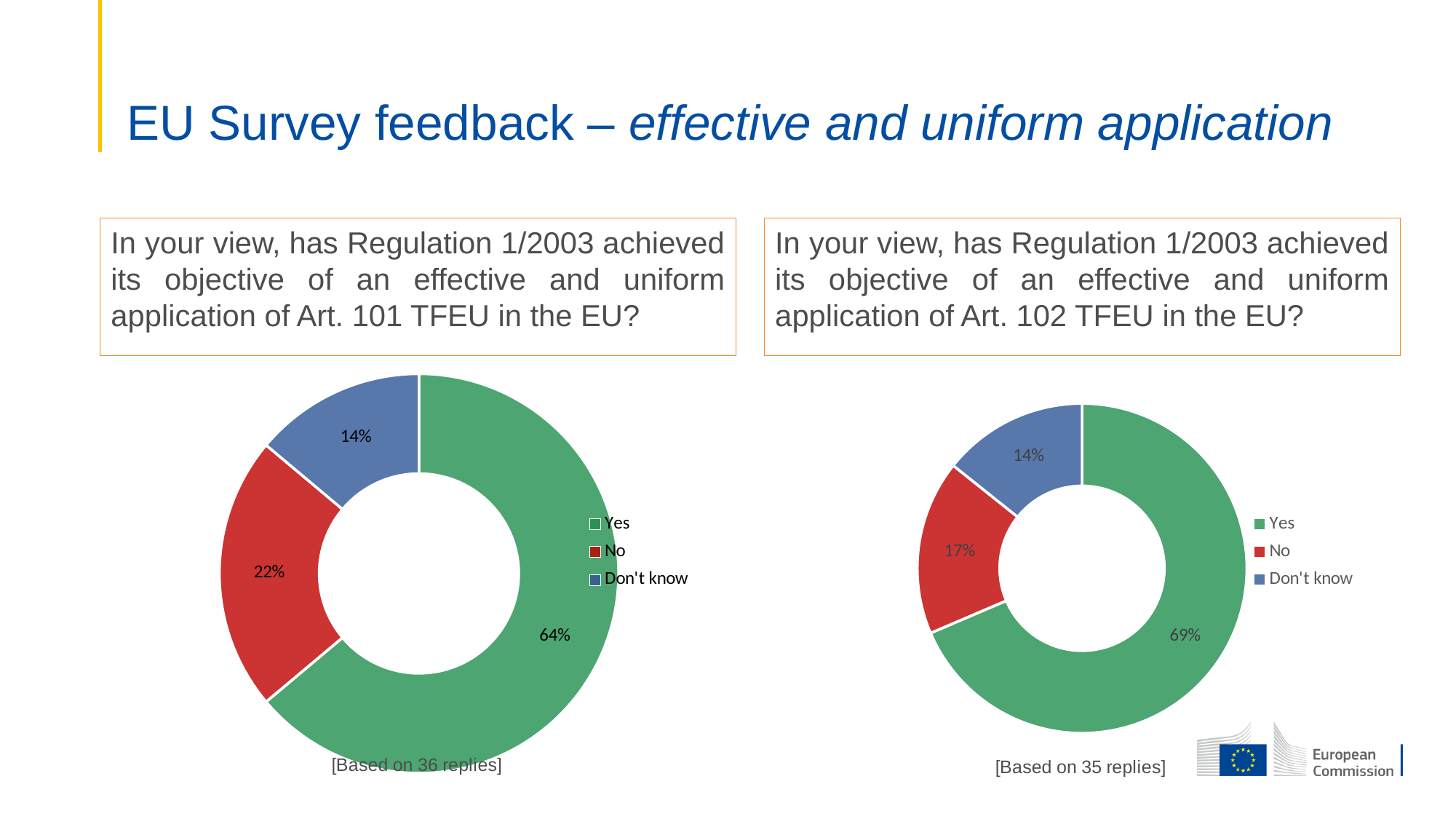
What type of chart is used on the left (Art. 101 TFEU)? Pie chart (doughnut) In the right chart (Art. 102 TFEU), what percentage of respondents answered Don't know? 14% In the right chart (Art. 102 TFEU), which response has the smallest share? Don't know How many replies is the left chart (Art. 101 TFEU) based on? 36 replies In the right chart (Art. 102 TFEU), what percentage of respondents answered No? 17% In the left chart (Art. 101 TFEU), what percentage of respondents answered No? 22% In the left chart (Art. 101 TFEU), which response has the largest share? Yes Is the Yes share larger in the left chart (Art. 101 TFEU) or the right chart (Art. 102 TFEU)? Right chart (Art. 102 TFEU) In the left chart (Art. 101 TFEU), what is the difference in percentage points between the Yes and No shares? 42 How many response categories does the legend of the right chart (Art. 102 TFEU) list? 3 In the left chart (Art. 101 TFEU), what percentage of respondents answered Yes? 64% In the right chart (Art. 102 TFEU), what percentage of respondents answered Yes? 69%